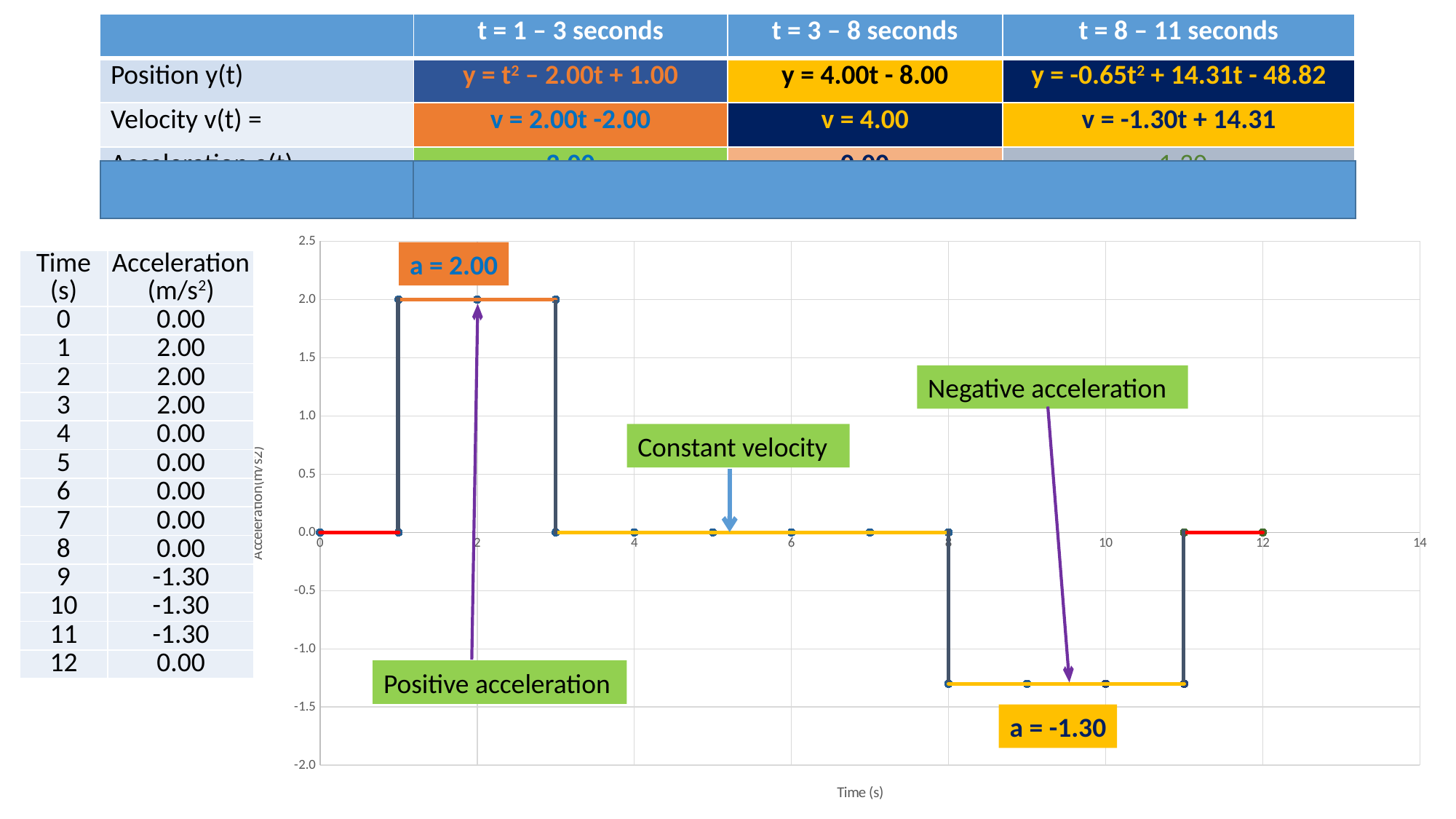
What is the acceleration value plotted at t = 5 seconds? 0.00 What kind of chart is shown on the slide? line chart What is the title of the horizontal axis of the chart? Time (s) Does the acceleration rise or fall between t = 8 seconds and t = 9 seconds? fall Is the acceleration value at t = 2 seconds greater or less than 1.0? greater What is the acceleration value plotted at t = 10 seconds? -1.30 What is the lowest acceleration value plotted on the chart? -1.30 What is the highest acceleration value plotted on the chart? 2.00 How many time points are listed in the acceleration data table? 13 What is the difference between the acceleration at t = 2 seconds and the acceleration at t = 10 seconds? 3.30 Which is larger, the acceleration at t = 1 second or the acceleration at t = 9 seconds? t = 1 second What is the acceleration value plotted at t = 2 seconds? 2.00